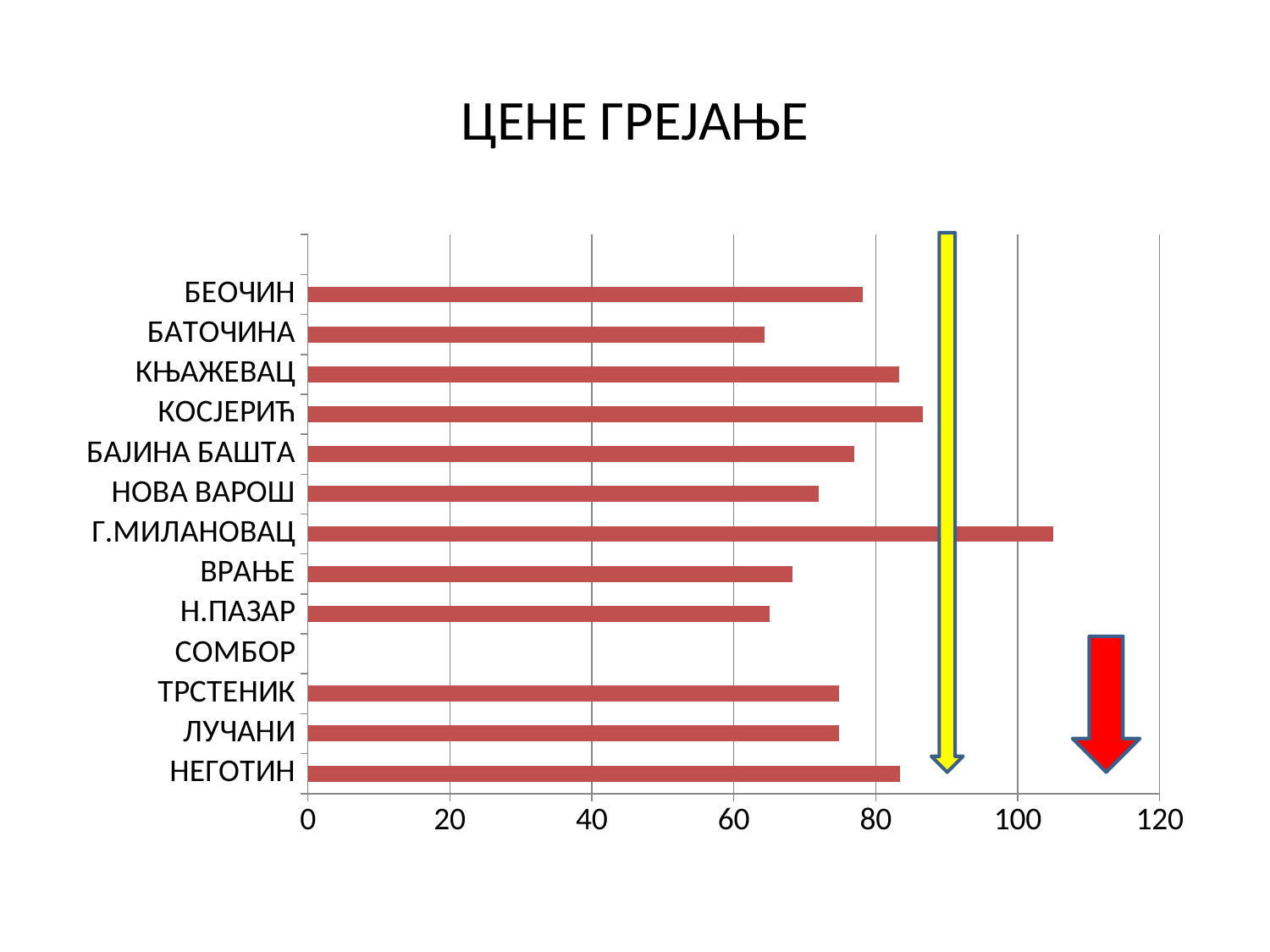
How many categories are listed on the chart's vertical axis? 13 Which category has the highest value? Г.МИЛАНОВАЦ Is the value for Г.МИЛАНОВАЦ greater or less than 100? greater Which is larger, the value for Г.МИЛАНОВАЦ or the value for БЕОЧИН? Г.МИЛАНОВАЦ What is the maximum value shown on the horizontal axis? 120 Is the value for БАТОЧИНА greater or less than 80? less Is the value for КОСЈЕРИЋ greater or less than 80? greater Which category has the lowest value (no visible bar)? СОМБОР Which is larger, the value for КОСЈЕРИЋ or the value for БАТОЧИНА? КОСЈЕРИЋ What is the title of the chart? ЦЕНЕ ГРЕЈАЊЕ What kind of chart is shown on the slide? bar chart